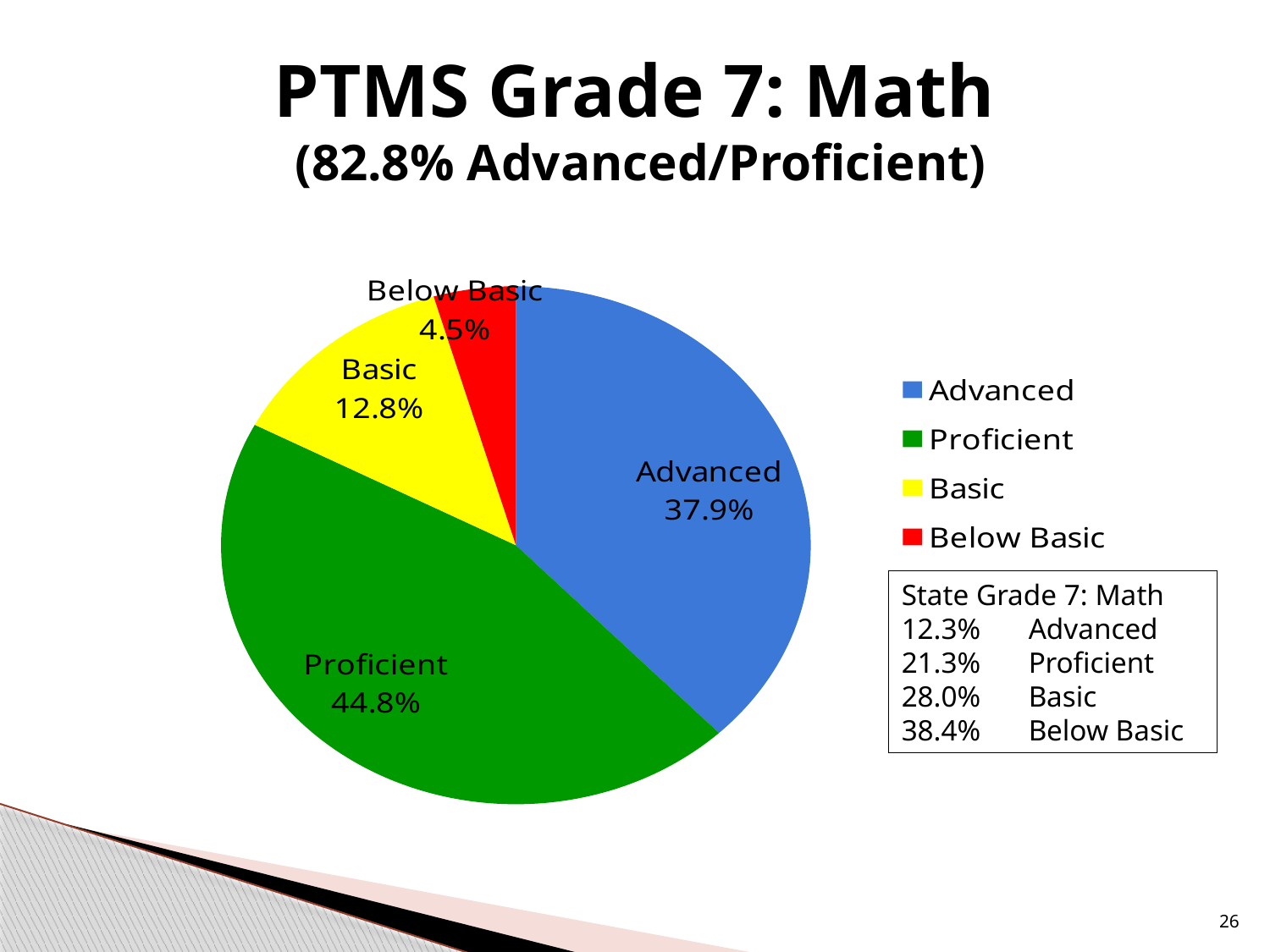
What percentage of PTMS Grade 7 students scored Proficient in Math? 44.8% What colour is the Proficient slice? Green Which is larger, the Basic slice or the Below Basic slice? Basic What is the difference between the Proficient and Advanced percentages? 6.9% What is the difference between the Basic and Below Basic percentages? 8.3% What kind of chart is shown on the slide? Pie chart What percentage of PTMS Grade 7 students scored Below Basic in Math? 4.5% Which category has the smallest slice of the pie? Below Basic Which category has the largest slice of the pie? Proficient What percentage of PTMS Grade 7 students scored Basic in Math? 12.8% How many categories does the pie chart show? 4 What percentage of PTMS Grade 7 students scored Advanced in Math? 37.9%